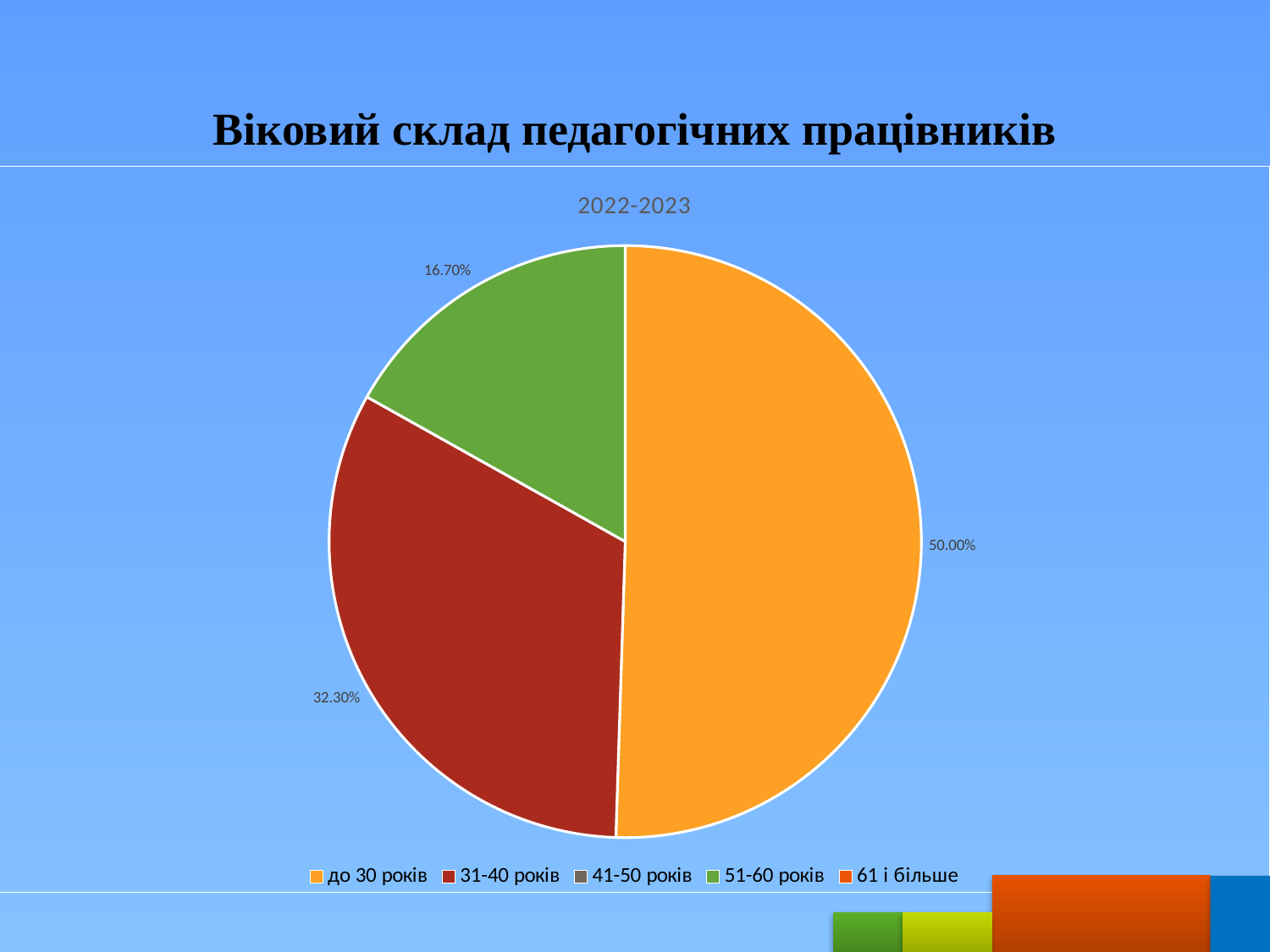
What is the difference in percentage points between the "31-40 років" slice and the "51-60 років" slice? 15.60% Which slice is larger: "31-40 років" or "51-60 років"? 31-40 років What percentage of the pie is the slice for "51-60 років"? 16.70% What type of chart is shown on the slide? pie chart What percentage of the pie is the slice for "до 30 років"? 50.00% What percentage of the pie is the slice for "31-40 років"? 32.30% Which of the three labelled slices is the smallest? 51-60 років What colour is the slice for "до 30 років"? orange What is the difference in percentage points between the "до 30 років" slice and the "31-40 років" slice? 17.70% How many entries does the legend list? 5 Which category has the largest slice of the pie? до 30 років What is the chart's title shown above the pie? 2022-2023